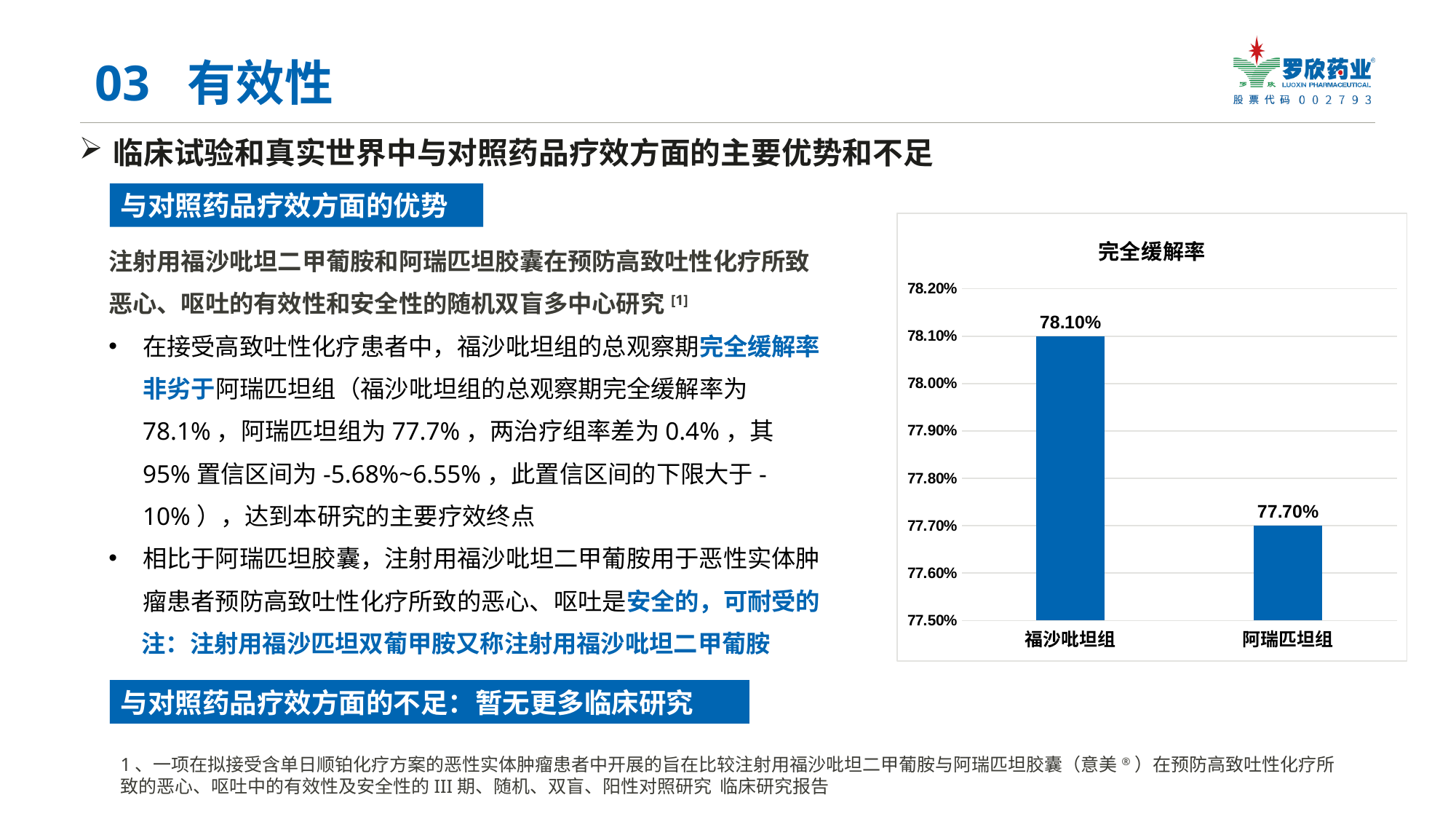
Is the value for 福沙吡坦组 greater or less than 78.00%? greater What is the title of the chart on the slide? 完全缓解率 Which is larger, the 完全缓解率 of 福沙吡坦组 or of 阿瑞匹坦组? 福沙吡坦组 What is the value for 阿瑞匹坦组 in the 完全缓解率 chart? 77.70% What is the difference between the 完全缓解率 of 福沙吡坦组 and 阿瑞匹坦组? 0.40% Is the value for 阿瑞匹坦组 greater or less than 78.00%? less What is the value for 福沙吡坦组 in the 完全缓解率 chart? 78.10% What kind of chart is used to show 完全缓解率? bar chart Which group has the highest 完全缓解率 in the chart? 福沙吡坦组 How many groups are shown in the 完全缓解率 chart? 2 What is the lowest value shown on the y axis of the 完全缓解率 chart? 77.50% Which group has the lowest 完全缓解率 in the chart? 阿瑞匹坦组